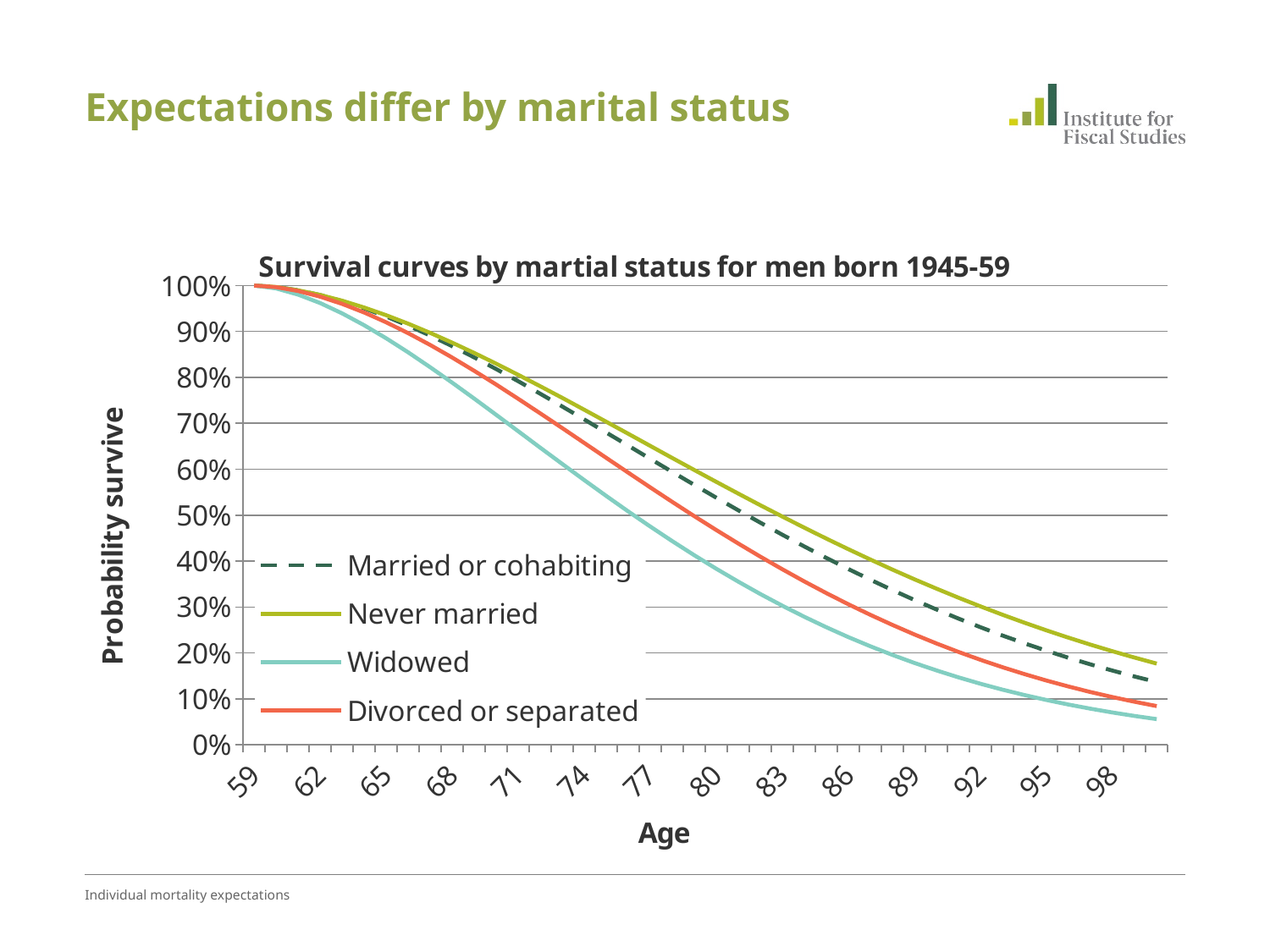
Is the value for Divorced or separated at age 89 greater or less than 20%? greater Do the survival probabilities rise or fall as age increases? fall What is the probability of survival for all series at age 59? 100% How many series does the legend list? 4 What is the label of the y axis? Probability survive Is the value for Never married at age 77 greater or less than 60%? greater Is the value for Widowed at age 98 greater or less than 10%? less Which series has the highest probability of survival at age 80? Never married At age 86, which is larger: the value for Married or cohabiting or the value for Widowed? Married or cohabiting What is the title of the chart? Survival curves by martial status for men born 1945-59 What kind of chart is shown on the slide? line chart Which series has the lowest probability of survival at age 80? Widowed